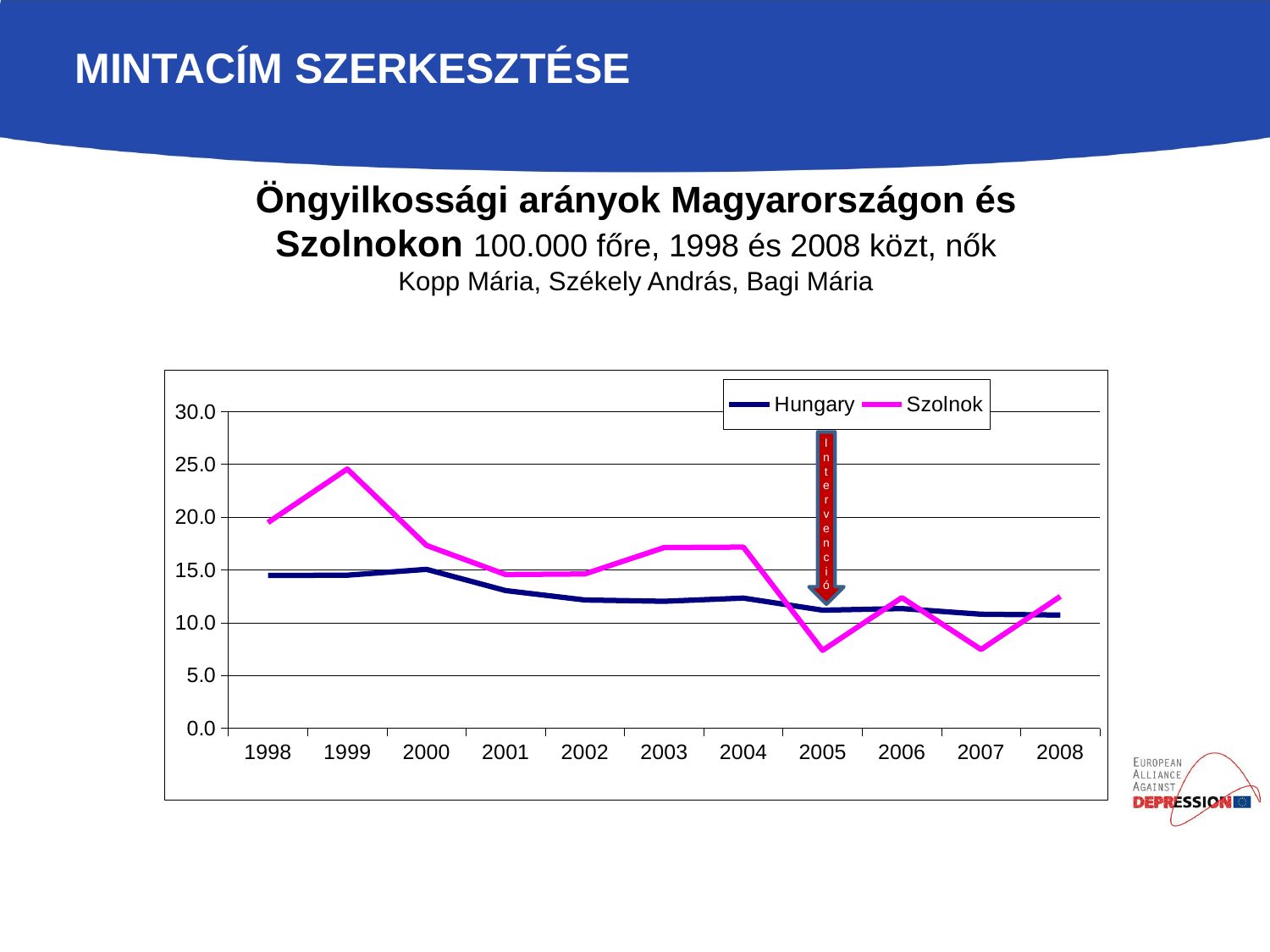
How many years are shown along the x axis of the chart? 11 In 2007, which series has the larger value, Hungary or Szolnok? Hungary How many series does the chart legend list? 2 Is the value for Szolnok in 1999 greater or less than 20.0? greater Is the value for Szolnok in 2005 greater or less than 10.0? less What kind of chart is shown on the slide? line chart Which colour is used for the Szolnok line in the chart? magenta (pink) Is the value for Szolnok in 2003 greater or less than 15.0? greater Does the Hungary series generally rise or fall from 1998 to 2008? fall In 1999, which series has the larger value, Hungary or Szolnok? Szolnok In which year does the Szolnok series reach its highest value? 1999